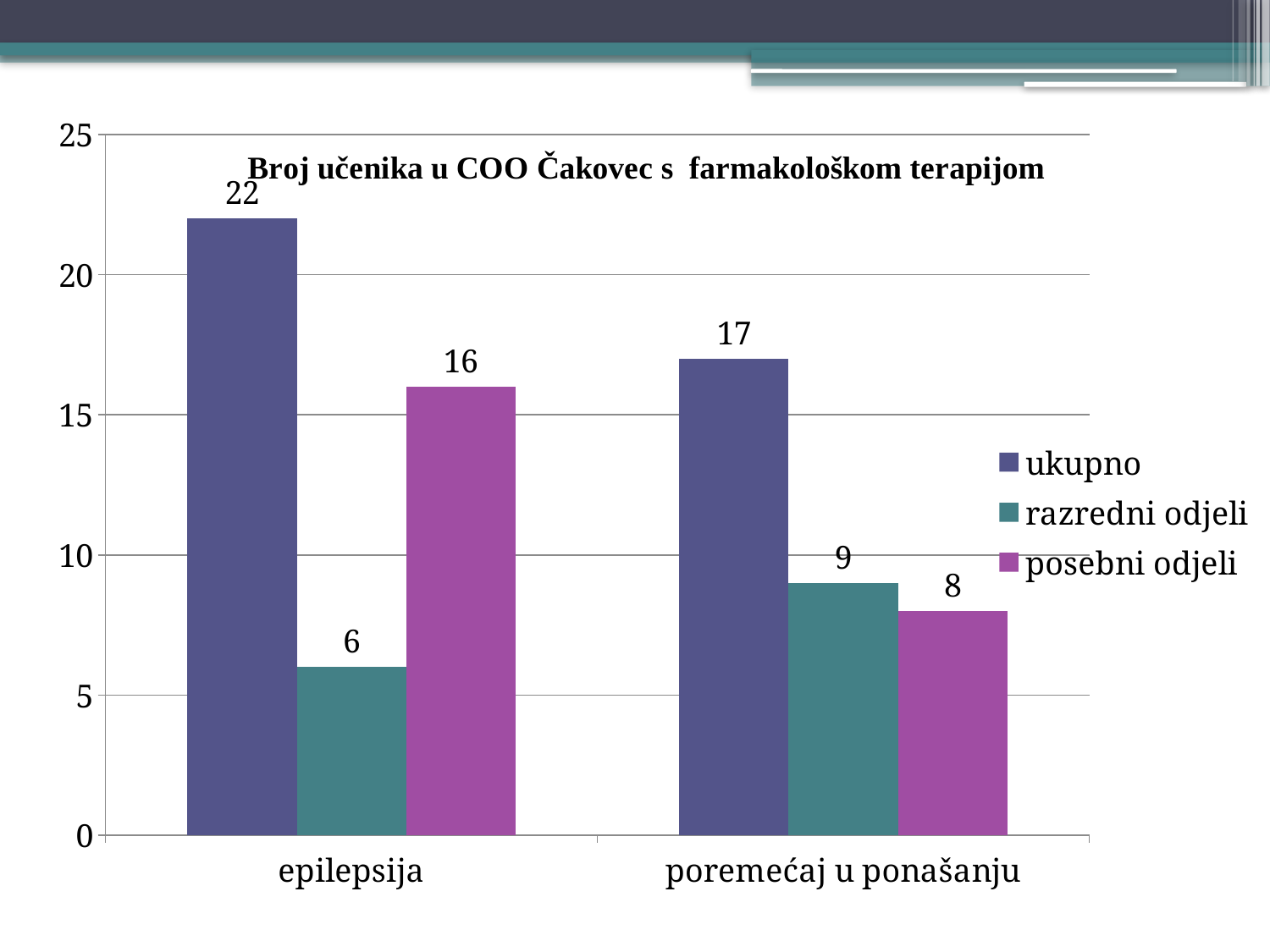
What is the title of the chart? Broj učenika u COO Čakovec s farmakološkom terapijom What is the difference between 'ukupno' for 'epilepsija' and 'ukupno' for 'poremećaj u ponašanju'? 5 Which series has the lowest value for 'epilepsija'? razredni odjeli Which category has the highest 'ukupno' value? epilepsija What is the value of 'ukupno' for 'epilepsija'? 22 What is the difference between 'posebni odjeli' and 'razredni odjeli' for 'epilepsija'? 10 What is the value of 'razredni odjeli' for 'poremećaj u ponašanju'? 9 What is the value of 'posebni odjeli' for 'epilepsija'? 16 Which is larger: 'razredni odjeli' for 'poremećaj u ponašanju' or 'posebni odjeli' for 'poremećaj u ponašanju'? razredni odjeli How many series does the legend list? 3 How many categories are shown on the x axis? 2 What kind of chart is shown on the slide? bar chart